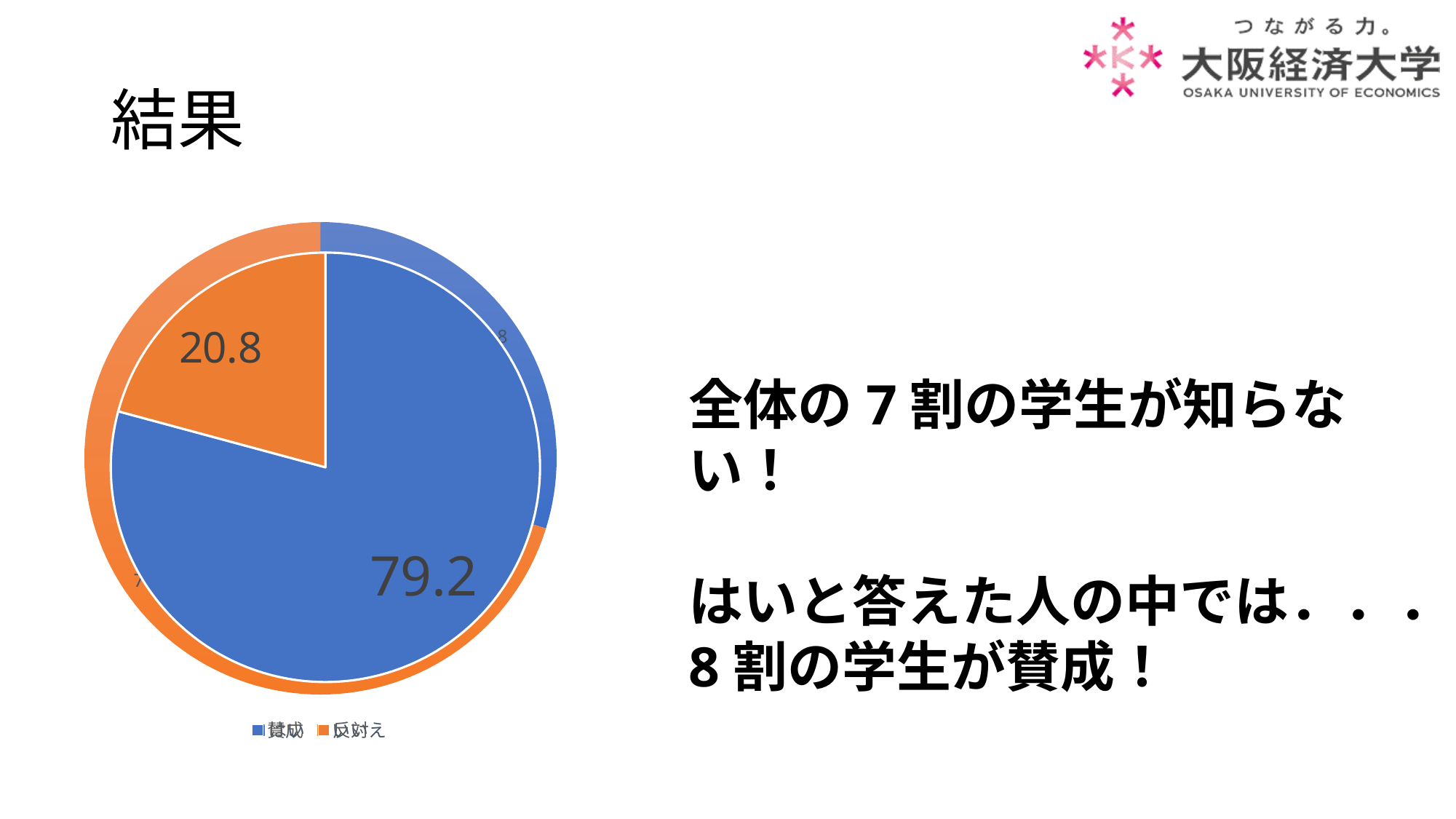
How many entries does the legend of the pie chart list? 2 What kind of chart is shown on the slide? Pie chart How many slices does the pie chart have? 2 What colour is the 賛成 slice in the pie chart? Blue What value is shown for the 賛成 slice of the pie chart? 79.2 What is the total of the two values labelled on the pie chart? 100 Which slice of the pie chart is the largest? 賛成